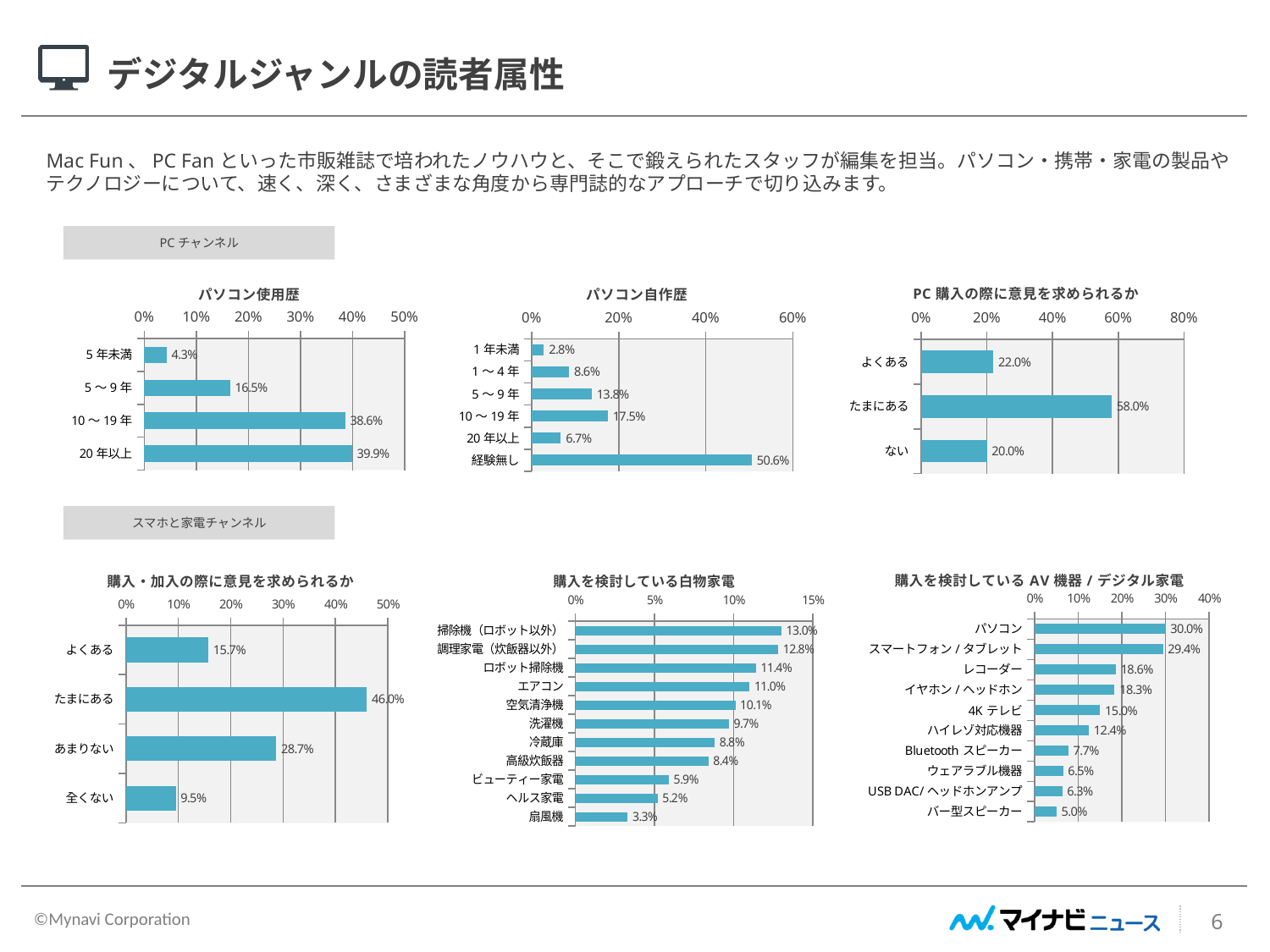
In the PC購入の際に意見を求められるか chart, what is the difference between たまにある and よくある? 36.0% In the 購入・加入の際に意見を求められるか chart, what is the value for あまりない? 28.7% In the パソコン自作歴 chart, what is the value for 1年未満? 2.8% In the パソコン自作歴 chart, which category has the highest value? 経験無し In the 購入を検討しているAV機器/デジタル家電 chart, what is the value for ハイレゾ対応機器? 12.4% In the PC購入の際に意見を求められるか chart, which category has the lowest value? ない In the 購入を検討しているAV機器/デジタル家電 chart, which is larger, レコーダー or 4Kテレビ? レコーダー In the 購入を検討している白物家電 chart, how many categories are shown? 11 In the 購入・加入の際に意見を求められるか chart, how many categories are shown? 4 In the パソコン使用歴 chart, what is the value for 10〜19年? 38.6% In the 購入を検討している白物家電 chart, which category has the lowest value? 扇風機 What type of chart is the パソコン使用歴 chart? Bar chart